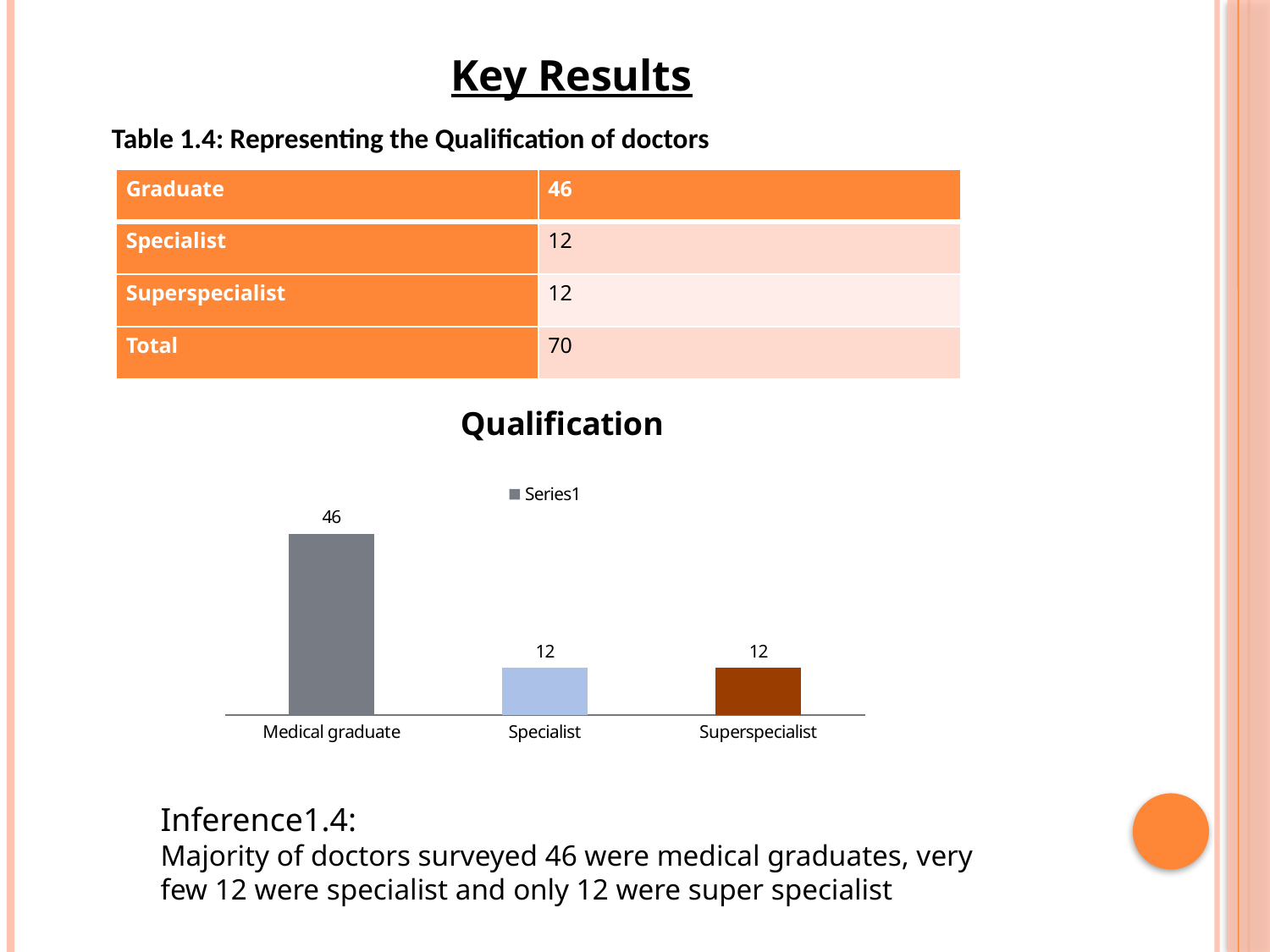
How many series does the legend of the Qualification chart list? 1 What is the value for Specialist in the Qualification chart? 12 What is the difference between the values for Medical graduate and Specialist in the Qualification chart? 34 What is the legend entry shown in the Qualification chart? Series1 Which is larger in the Qualification chart, the value for Medical graduate or the value for Superspecialist? Medical graduate How many categories are shown in the Qualification chart? 3 What kind of chart is the Qualification chart? bar chart Which category has the highest value in the Qualification chart? Medical graduate What is the total of the three values plotted in the Qualification chart? 70 What is the title of the chart on the slide? Qualification What is the value for Medical graduate in the Qualification chart? 46 What is the value for Superspecialist in the Qualification chart? 12